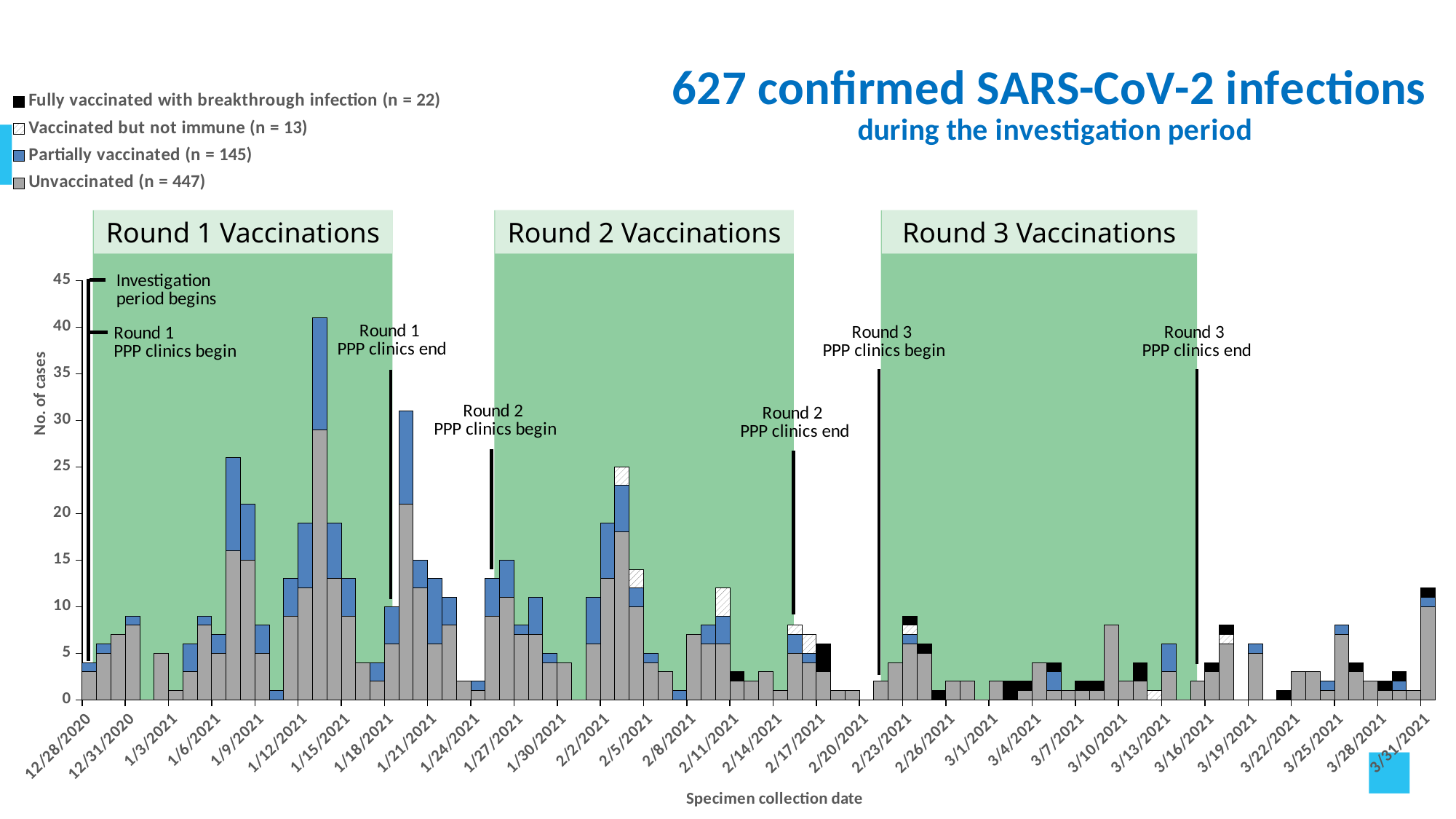
Which date has more cases, 12/28/2020 or 3/31/2021? 3/31/2021 What kind of chart is shown on the slide? Stacked bar chart Is the number of cases for 12/28/2020 greater or less than 5? less How many series does the legend list? 4 Do the daily case counts rise or fall from 12/28/2020 to 12/31/2020? rise Is the number of cases for 3/31/2021 greater or less than 10? greater Which date has more cases, 1/3/2021 or 1/6/2021? 1/6/2021 How many more unvaccinated cases (n = 447) were there than partially vaccinated cases (n = 145), according to the legend? 302 How many vaccination rounds are marked as shaded periods on the chart? 3 According to the legend, how many cases were unvaccinated? 447 What is the main title of the chart? 627 confirmed SARS-CoV-2 infections Is the tallest bar on the chart greater or less than 35 cases? greater